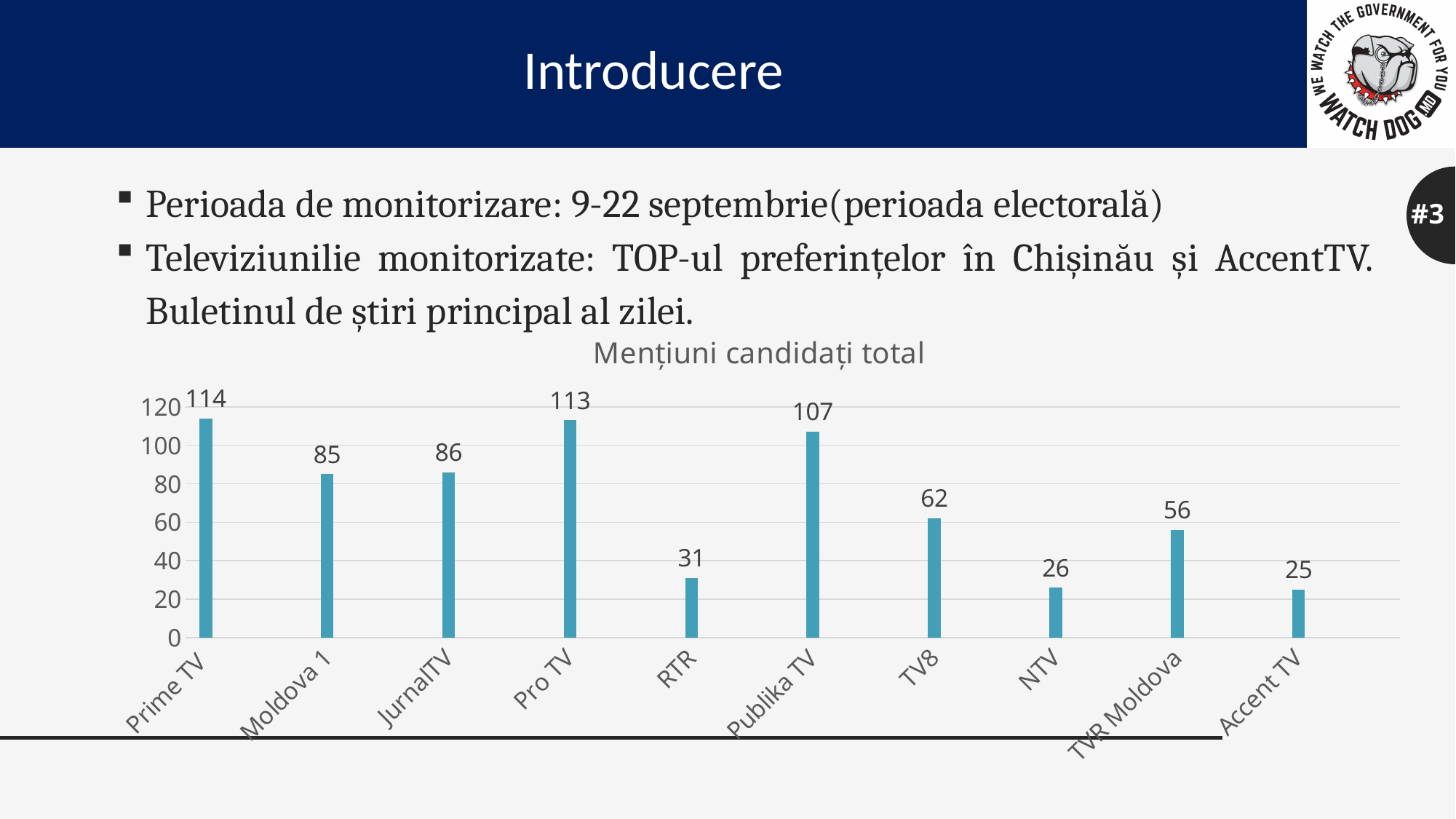
Is the value for NTV greater or less than 40? less Which category has the lowest value? Accent TV What is the difference between the values for Pro TV and TV8? 51 Which is larger, the value for Moldova 1 or the value for TVR Moldova? Moldova 1 Which category has the highest value? Prime TV What is the value for RTR? 31 What kind of chart is shown on the slide? bar chart What is the difference between the values for JurnalTV and Moldova 1? 1 What is the value for Publika TV? 107 How many categories are shown on the x axis? 10 What is the title of the chart? Mențiuni candidați total What is the value for Prime TV? 114